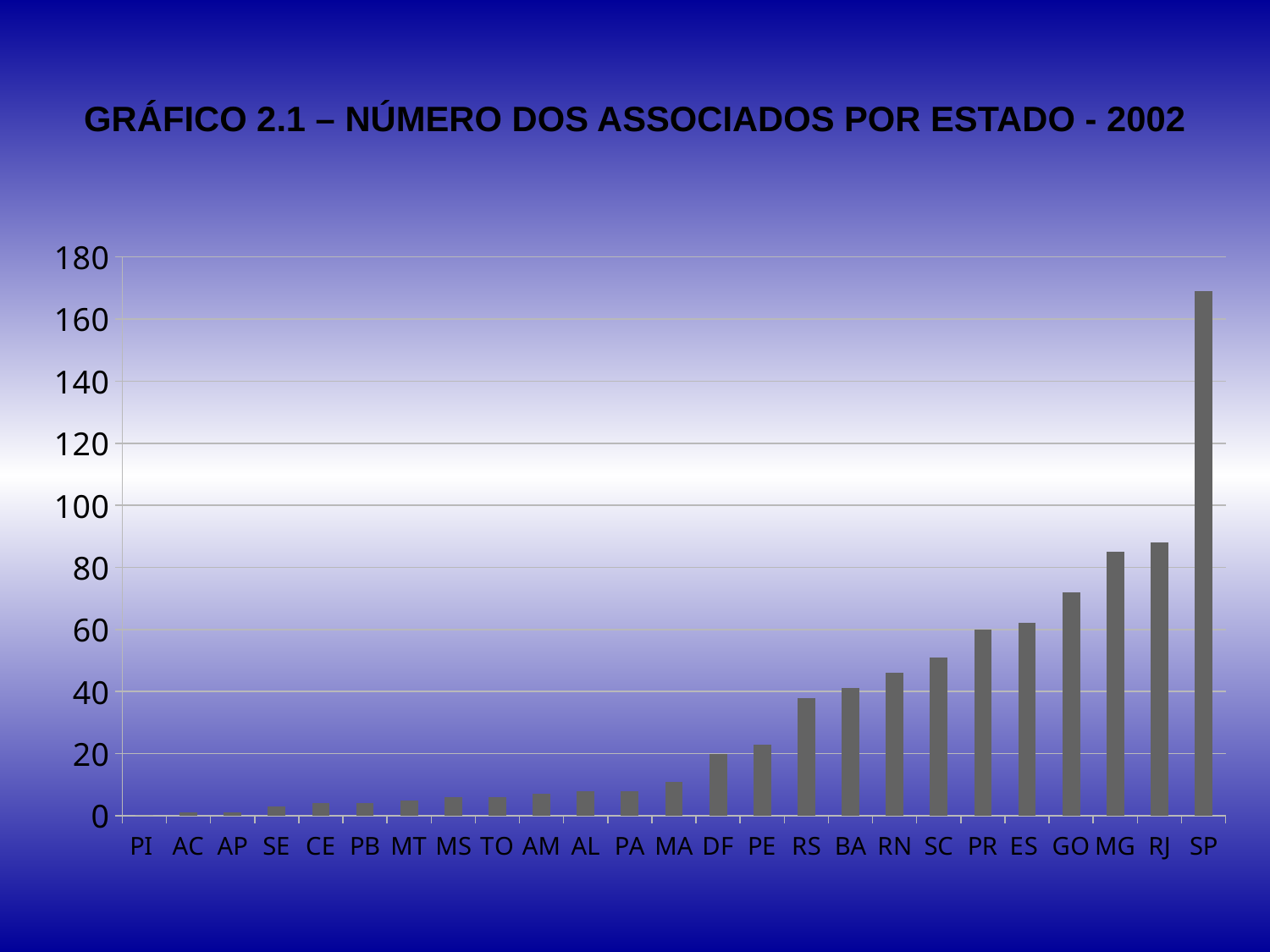
What is the title of the chart? GRÁFICO 2.1 – NÚMERO DOS ASSOCIADOS POR ESTADO - 2002 Do the values rise or fall moving from left to right along the x axis? rise What kind of chart is shown on the slide? bar chart Which state has the lowest number of associates? PI Is the value for SC greater or less than 40? greater How many states (categories) are shown on the x axis? 25 Which has a larger value, GO or PR? GO Is the value for MA greater or less than 20? less Is the value for RJ greater or less than 100? less Which state has the highest number of associates? SP